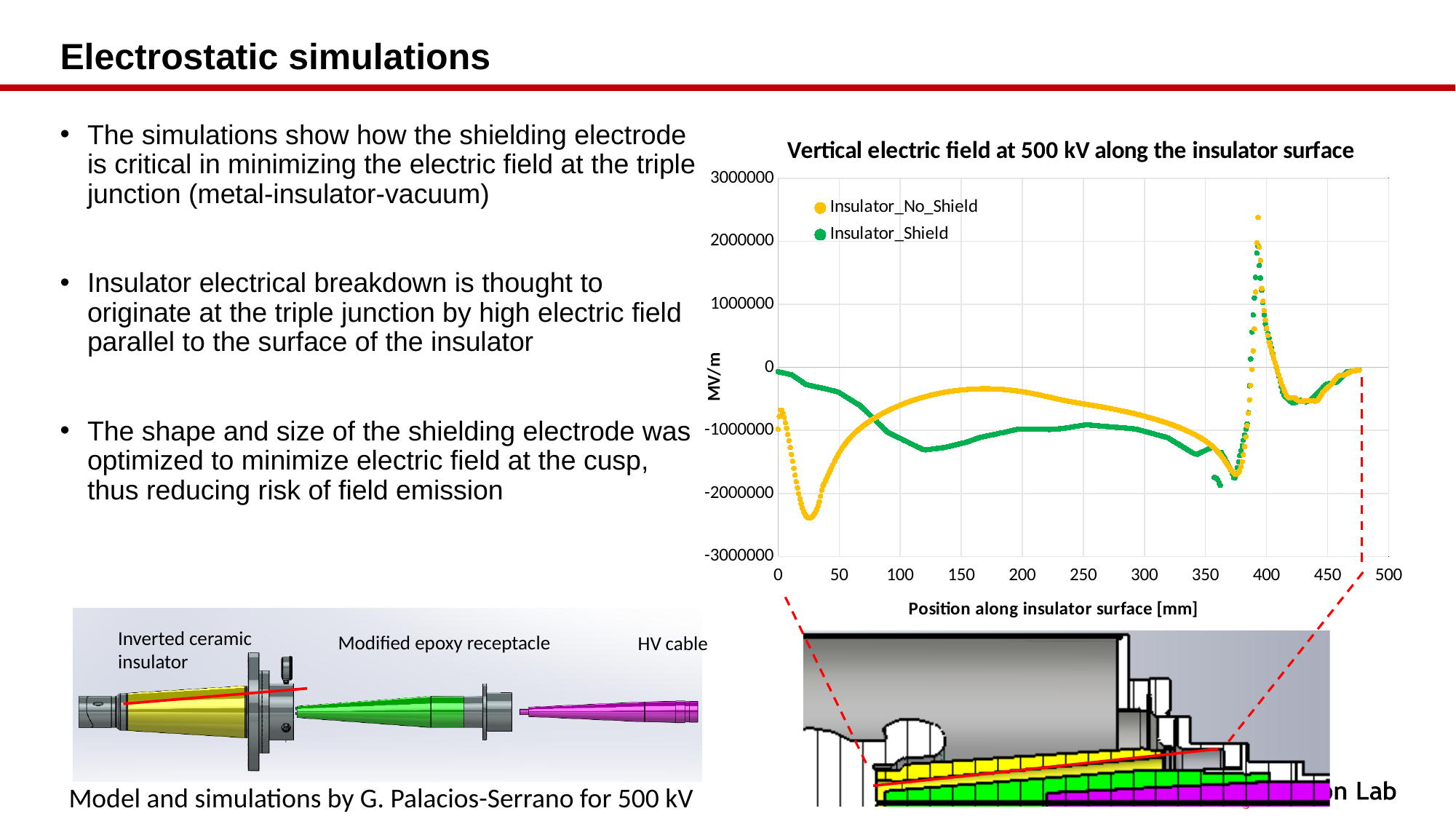
How many series does the legend of the chart list? 2 Is the value of the Insulator_Shield series at position 0 mm greater or less than -1000000? greater Is the lowest value of the Insulator_No_Shield series (near 25 mm) greater or less than -2000000? less Which series reaches the lower (more negative) value near position 25 mm, Insulator_No_Shield or Insulator_Shield? Insulator_No_Shield What kind of chart is shown on the slide? scatter chart Between positions 0 mm and 120 mm, does the Insulator_Shield series rise or fall? fall Which series reaches the higher peak value near position 390 mm, Insulator_No_Shield or Insulator_Shield? Insulator_No_Shield Is the highest value of the Insulator_No_Shield series (near 390 mm) greater or less than 2000000? greater What is the label of the x axis of the chart? Position along insulator surface [mm] What is the title of the chart? Vertical electric field at 500 kV along the insulator surface